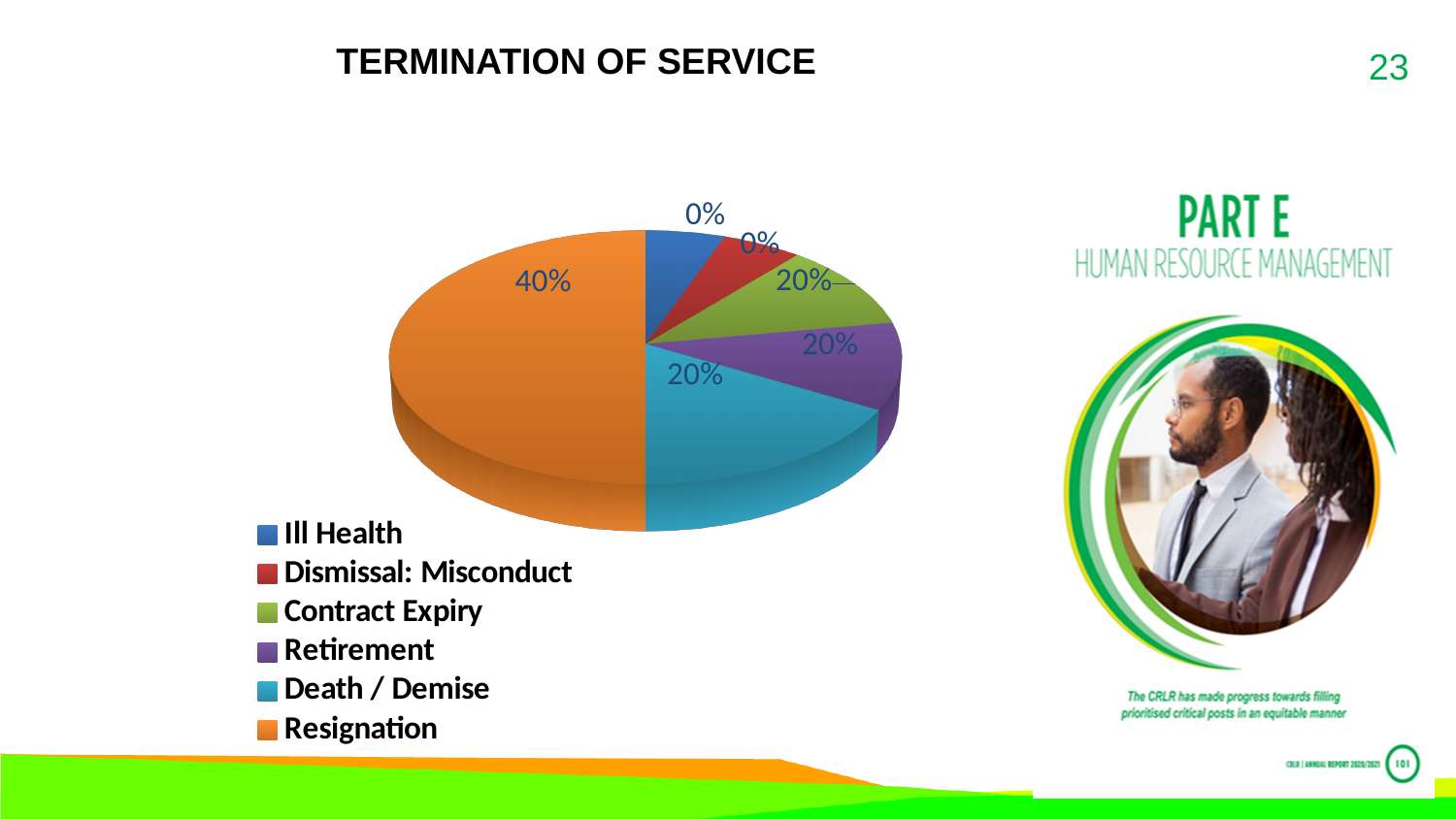
Which colour represents Resignation in the pie chart? Orange What share of the pie does Resignation account for? 40% What percentage is shown for Contract Expiry? 20% What is the title of the chart on the slide? TERMINATION OF SERVICE What percentage is shown for Retirement? 20% What kind of chart is shown on the slide? Pie chart What is the difference between the share for Resignation and the share for Retirement? 20% How many categories does the legend of the pie chart list? 6 Which category has the largest share of the pie? Resignation What percentage label is shown for Dismissal: Misconduct? 0% What percentage label is shown for Ill Health? 0% What percentage is shown for Death / Demise? 20%